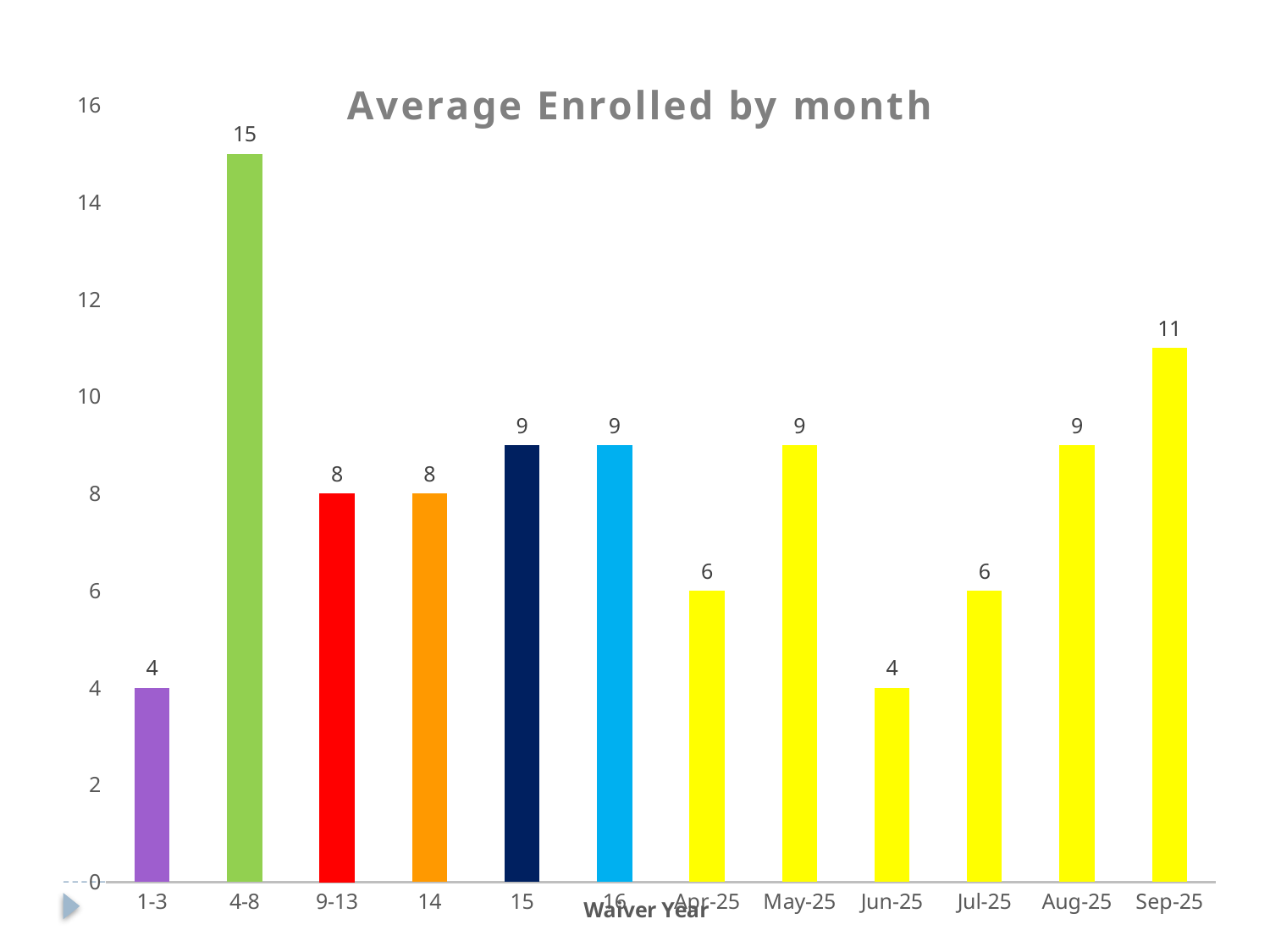
What is the x-axis title of the chart? Waiver Year What is the value for Sep-25? 11 What is the difference between the values for 4-8 and 1-3? 11 Which is larger, the value for Apr-25 or the value for May-25? May-25 What is the value for 9-13? 8 How many categories are shown on the x axis? 12 Which category has the highest value? 4-8 What is the difference between the values for Sep-25 and Aug-25? 2 What kind of chart is shown on the slide? bar chart What is the value for 4-8 in the Average Enrolled by month chart? 15 What is the title of the chart? Average Enrolled by month What is the value for Jun-25? 4